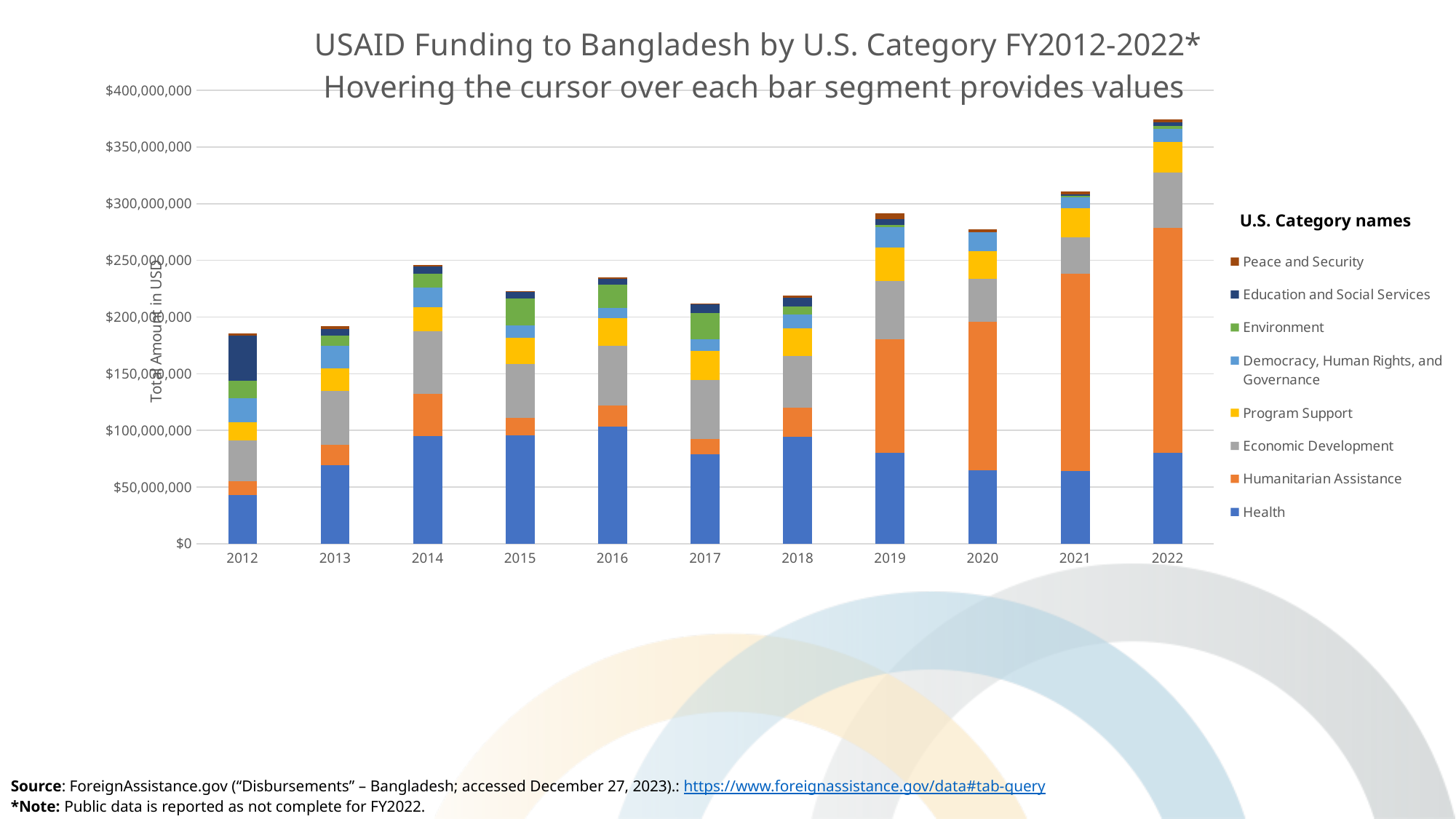
Which year has the larger total funding, 2021 or 2022? 2022 Is the total funding for 2012 greater or less than $200,000,000? less How many fiscal years are shown on the x axis? 11 What is the title of the legend? U.S. Category names Which fiscal year has the highest total USAID funding to Bangladesh? 2022 How many U.S. categories does the legend list? 8 What kind of chart is shown on the slide? Stacked bar chart Is the Health segment for 2012 greater or less than $50,000,000? less Overall, does total funding rise or fall from 2012 to 2022? Rise Which year has the larger total funding, 2014 or 2015? 2014 Is the total funding for 2022 greater or less than $350,000,000? greater